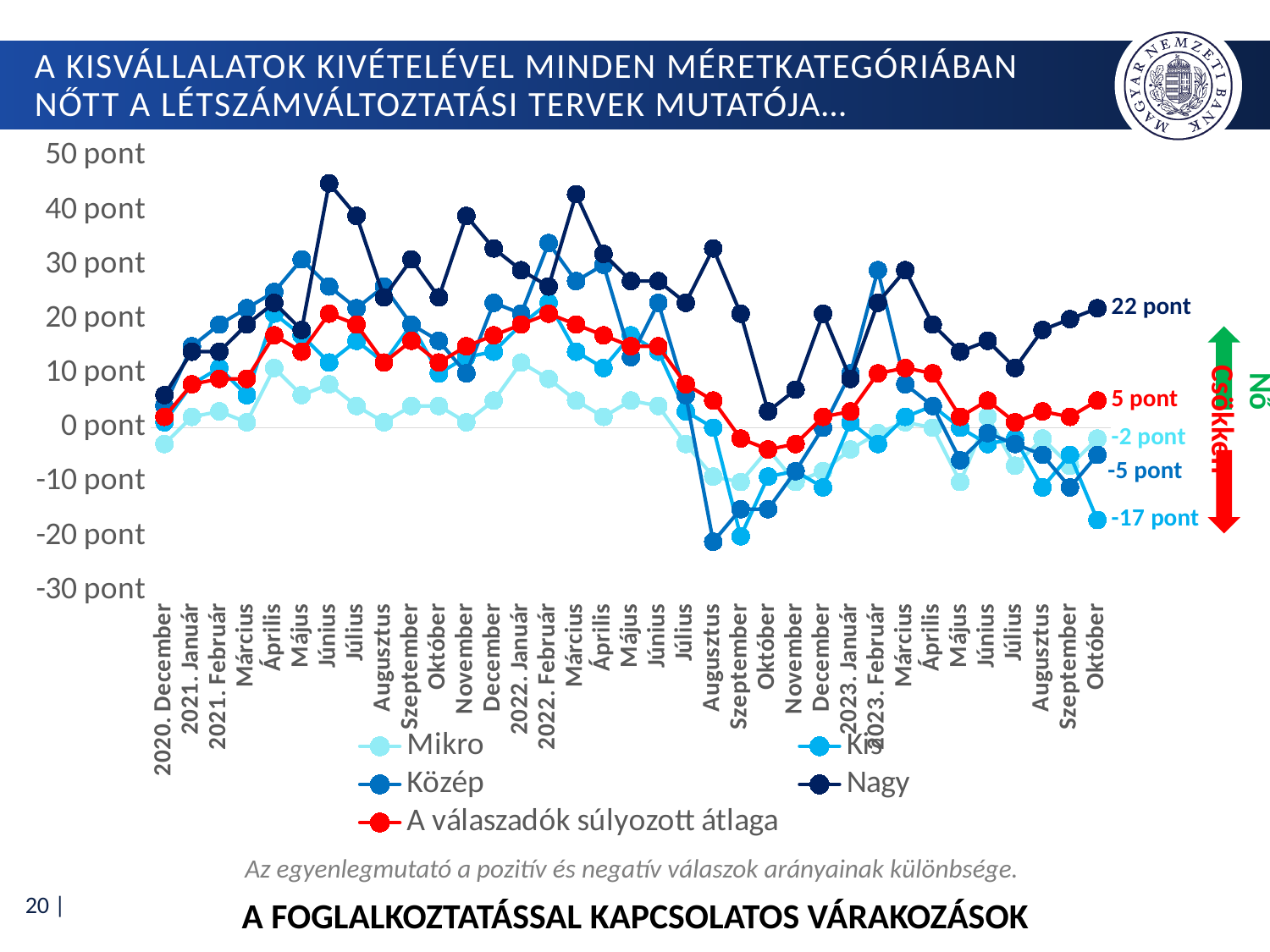
How many series does the legend list? 5 In 2023. Október, which is larger: the value for Mikro or the value for Közép? Mikro Is the value for Nagy in 2021. Június greater or less than 40 pont? greater What is the value for Kis in 2023. Október? -17 pont What kind of chart is shown on the slide? line chart What is the value for Közép in 2023. Október? -5 pont Which series has the highest value in 2023. Október? Nagy What is the value for Nagy in 2023. Október? 22 pont What is the value for Mikro in 2023. Október? -2 pont What is the difference between the Nagy and Kis values in 2023. Október? 39 pont Which series has the lowest value in 2023. Október? Kis What is the value for A válaszadók súlyozott átlaga in 2023. Október? 5 pont